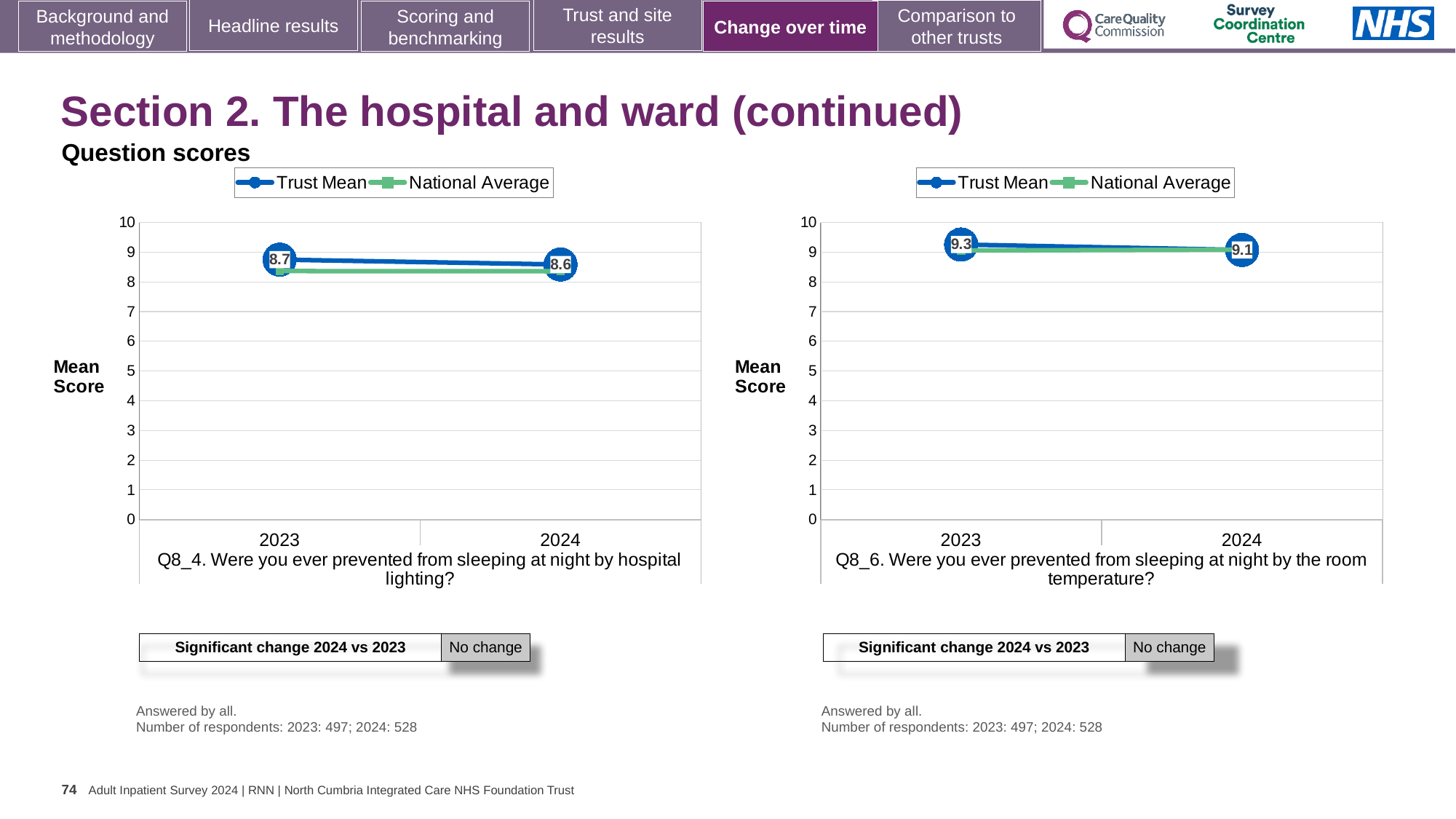
In the Q8_6 chart (right), what is the Trust Mean score for 2023? 9.3 In the Q8_4 chart (left), what is the Trust Mean score for 2024? 8.6 In the Q8_4 chart (left), what is the Trust Mean score for 2023? 8.7 In the Q8_4 chart (left), is the National Average value for 2023 greater or less than 7? greater In the Q8_4 chart (left), does the Trust Mean rise or fall from 2023 to 2024? fall How many series does the legend of the Q8_6 chart (right) list? 2 How many years are plotted on the x axis of the Q8_4 chart (left)? 2 In the Q8_6 chart (right), by how much did the Trust Mean change from 2023 to 2024? 0.2 In the Q8_6 chart (right), what is the Trust Mean score for 2024? 9.1 What is the significant change result shown below the Q8_6 chart (right) for 2024 vs 2023? No change What type of chart is used for the Q8_4 question on the left? line chart Which chart has the higher Trust Mean for 2023, the Q8_4 chart (left) or the Q8_6 chart (right)? Q8_6 chart (right)